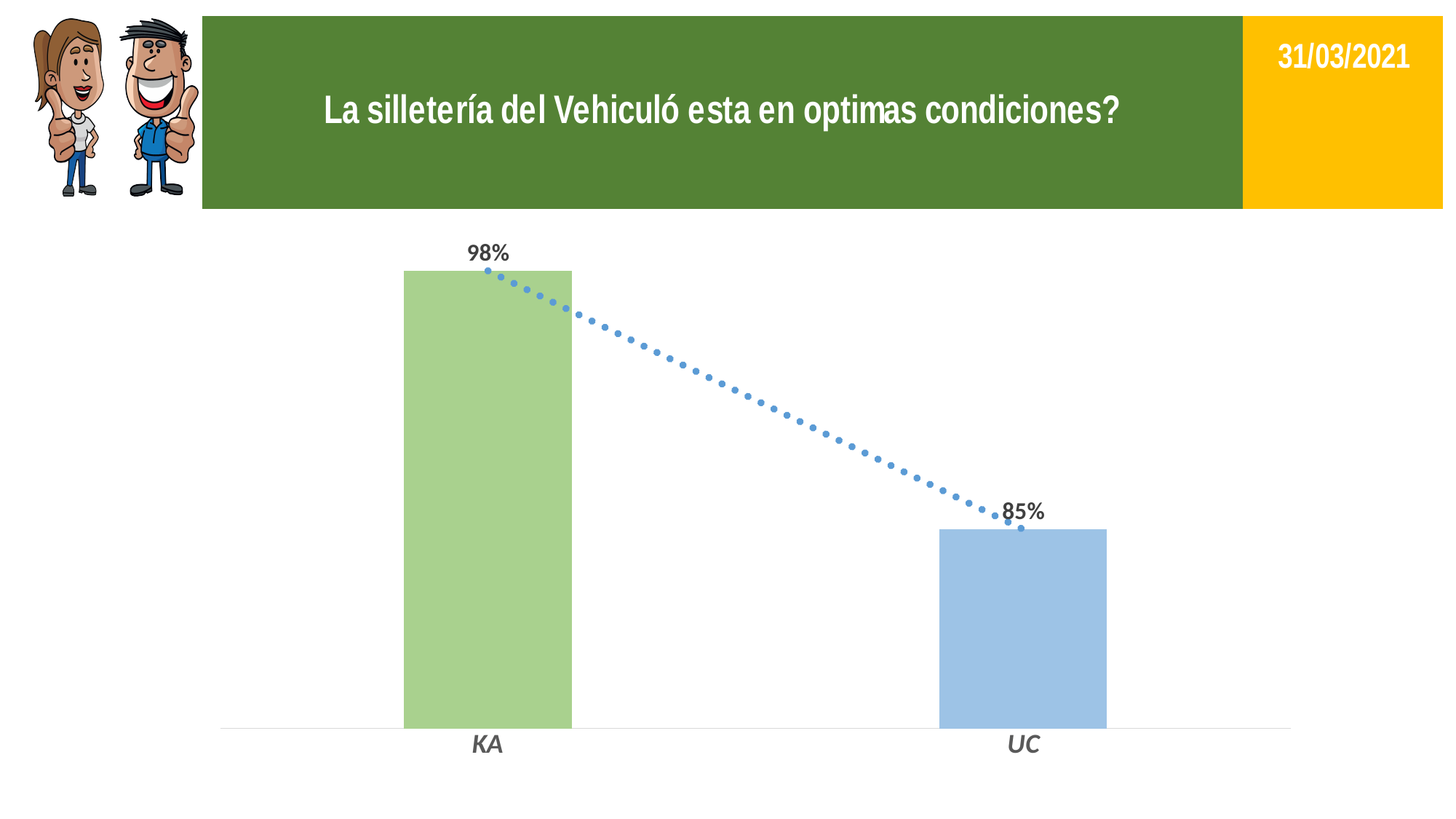
How many categories are shown on the chart? 2 What is the value for KA? 98% Do the values rise or fall from KA to UC? Fall Which category has the lowest value? UC What colour is the bar for UC? Blue What colour is the bar for KA? Green Which is larger, the value for KA or the value for UC? KA What is the value for UC? 85% What is the difference between the values for KA and UC? 13% What kind of chart is shown on the slide? Bar chart Which category has the highest value? KA